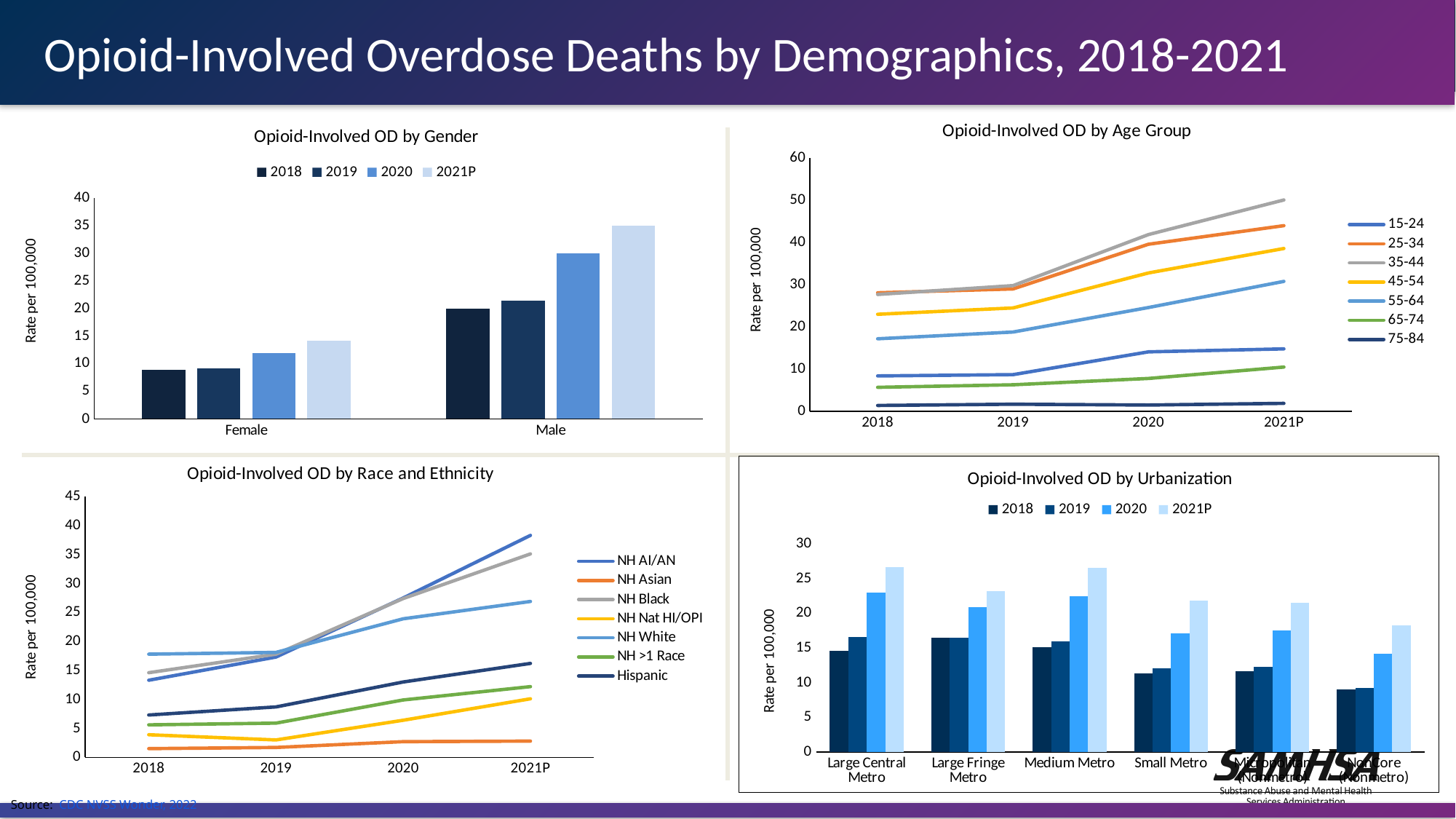
In the 'Opioid-Involved OD by Age Group' chart, which age group has the lowest rate across all years? 75-84 In the 'Opioid-Involved OD by Age Group' chart, which age group has the highest rate in 2021P? 35-44 In the 'Opioid-Involved OD by Urbanization' chart, is the value for Noncore (Nonmetro) in 2018 greater or less than 10? less What kind of chart is the 'Opioid-Involved OD by Age Group' chart? line chart How many age groups does the legend of the 'Opioid-Involved OD by Age Group' chart list? 7 How many series does the legend of the 'Opioid-Involved OD by Gender' chart list? 4 In the 'Opioid-Involved OD by Gender' chart, is the value for Male in 2021P greater or less than 30? greater In the 'Opioid-Involved OD by Race and Ethnicity' chart, which group has the highest rate in 2021P? NH AI/AN In the 'Opioid-Involved OD by Race and Ethnicity' chart, which group has the lowest rate in 2021P? NH Asian What kind of chart is the 'Opioid-Involved OD by Gender' chart? bar chart In the 'Opioid-Involved OD by Gender' chart, which gender has the higher rate in 2020? Male In the 'Opioid-Involved OD by Urbanization' chart, how many urbanization categories are shown on the x axis? 6